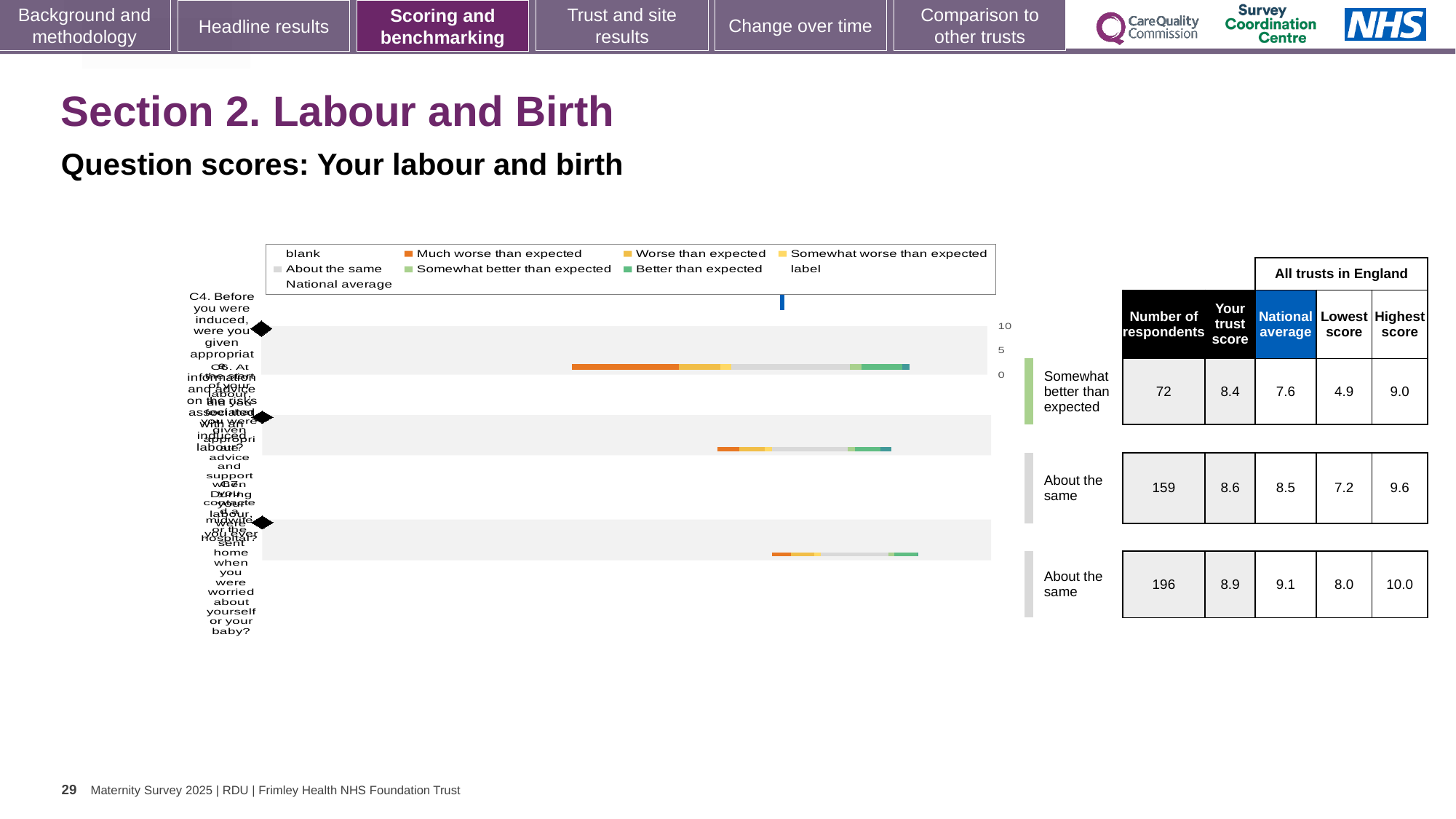
In the table, what is the national average for the row with 196 respondents? 9.1 In the table, what is the highest score for the row with 72 respondents? 9.0 In the table, what is the lowest score for the row with 159 respondents? 7.2 In the table, is the trust score for the row with 196 respondents higher or lower than its national average? Lower In the table, what is the number of respondents for the first row (rated 'Somewhat better than expected')? 72 In the table, what is the difference between the highest and lowest score for the row with 196 respondents? 2.0 Which table row has the largest number of respondents? The third row (196) How many question bars are plotted in the chart? 3 In the table, what is the trust score for the row with 159 respondents? 8.6 What colour does the legend use for 'Much worse than expected'? Orange What kind of chart is shown on the slide? Horizontal stacked bar chart In the table, what is the difference between the trust score and the national average for the row with 72 respondents? 0.8